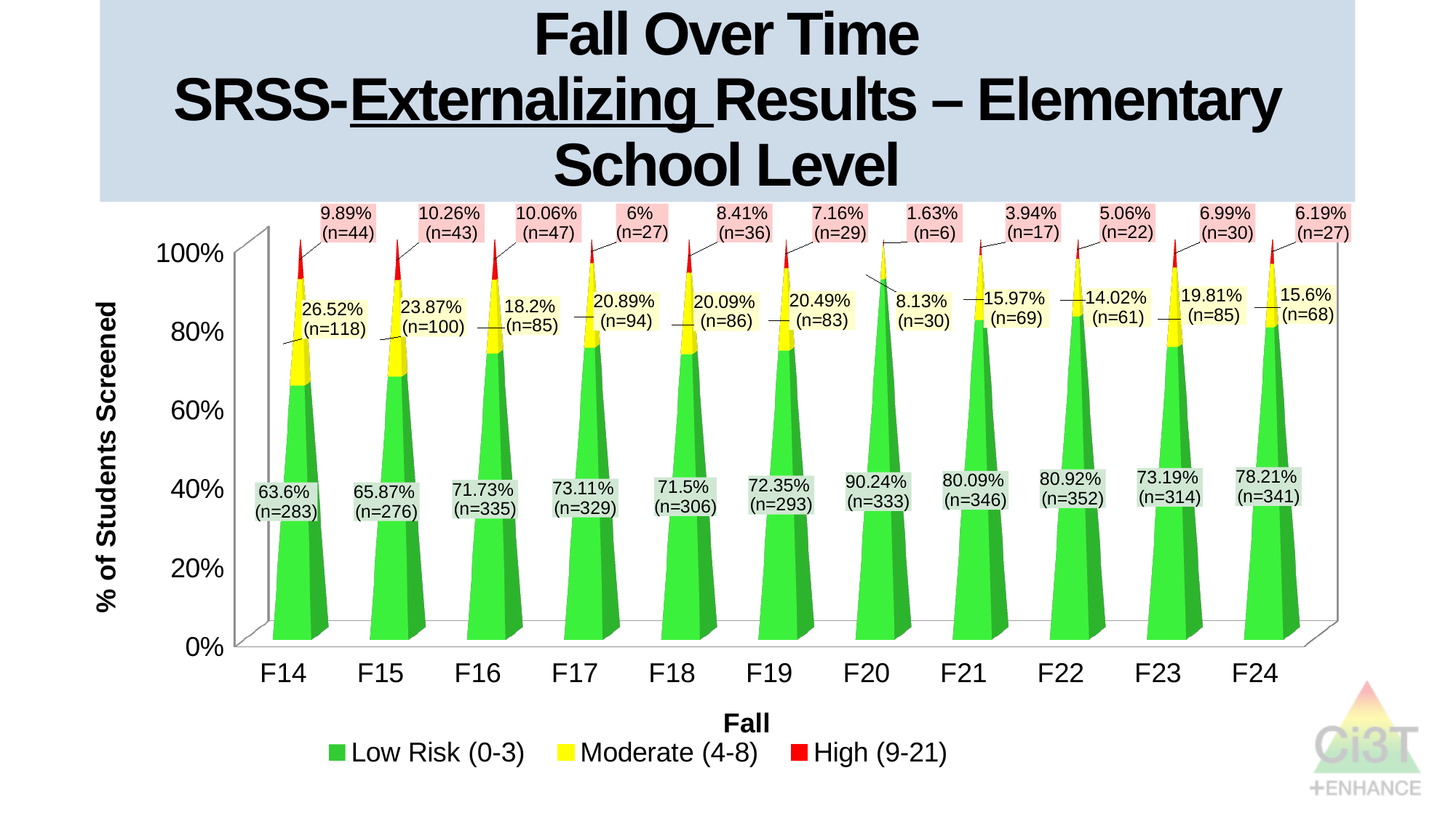
What percentage of students were in the High (9-21) category in F15? 10.26% How many series does the legend list? 3 Which fall term had the highest percentage of Low Risk (0-3) students? F20 What is the label of the y axis? % of Students Screened Which had a larger Low Risk (0-3) percentage, F21 or F22? F22 What kind of chart is shown on the slide? Stacked bar chart How many students (n) were in the Moderate (4-8) category in F24? 68 Which fall term had the lowest percentage of Low Risk (0-3) students? F14 How many fall terms are shown on the x axis? 11 What is the difference in percentage points between the Low Risk (0-3) share in F20 and in F14? 26.64 Which fall term had the lowest percentage of High (9-21) students? F20 What percentage of students were Low Risk (0-3) in F20? 90.24%